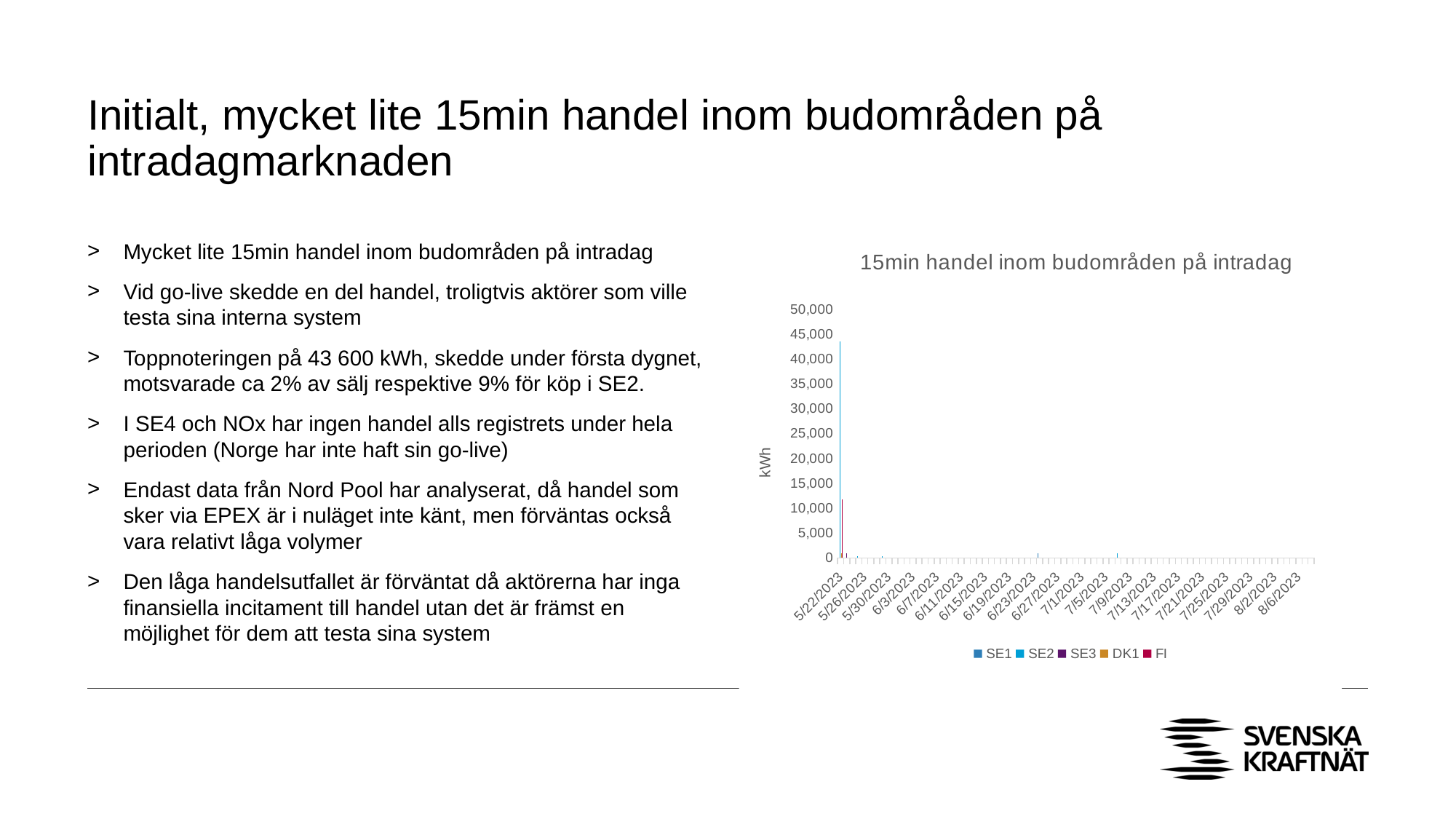
Is the value for 7/1/2023 in the chart greater or less than 5,000 kWh? less What is the highest tick value shown on the y-axis of the chart? 50,000 Is the tallest bar in the chart greater or less than 40,000 kWh? greater Do the traded volumes in the chart generally rise or fall from the start of the period to the end? fall Which series has the tallest bar in the chart? SE2 How many series does the legend of the chart list? 5 What is the first date label on the x-axis of the chart? 5/22/2023 Which series are listed in the chart's legend? SE1, SE2, SE3, DK1, FI Is the tallest bar in the chart greater or less than 45,000 kWh? less What is the title of the chart? 15min handel inom budområden på intradag What is the last date label on the x-axis of the chart? 8/6/2023 What kind of chart is shown on the slide? bar chart